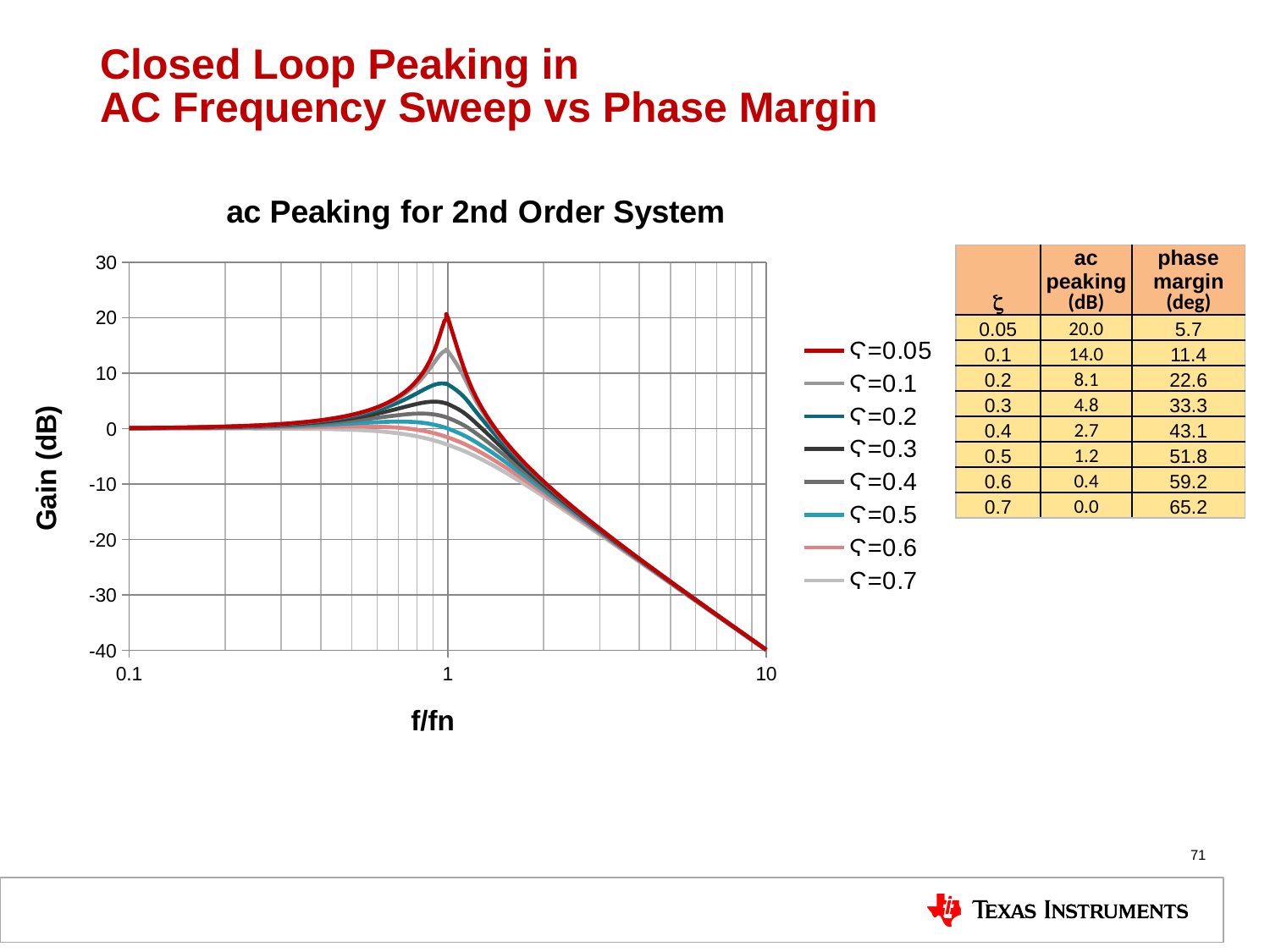
According to the table next to the chart, what is the ac peaking (dB) for ζ = 0.3? 4.8 What is the title of the chart on the slide? ac Peaking for 2nd Order System In the "ac Peaking for 2nd Order System" chart, which series reaches the highest peak gain? ζ=0.05 In the "ac Peaking for 2nd Order System" chart, does the gain rise or fall as f/fn goes from 1 to 10? falls How many series does the legend of the "ac Peaking for 2nd Order System" chart list? 8 In the "ac Peaking for 2nd Order System" chart, is the gain at f/fn = 10 greater or less than -30? less According to the table next to the chart, what is the phase margin (deg) for ζ = 0.5? 51.8 In the "ac Peaking for 2nd Order System" chart, which curve has the higher peak, ζ=0.1 or ζ=0.2? ζ=0.1 What kind of chart is "ac Peaking for 2nd Order System"? line chart What is the y-axis label of the "ac Peaking for 2nd Order System" chart? Gain (dB) In the "ac Peaking for 2nd Order System" chart, is the peak gain of the ζ=0.05 curve greater or less than 10? greater In the "ac Peaking for 2nd Order System" chart, is the peak gain of the ζ=0.7 curve greater or less than 10? less